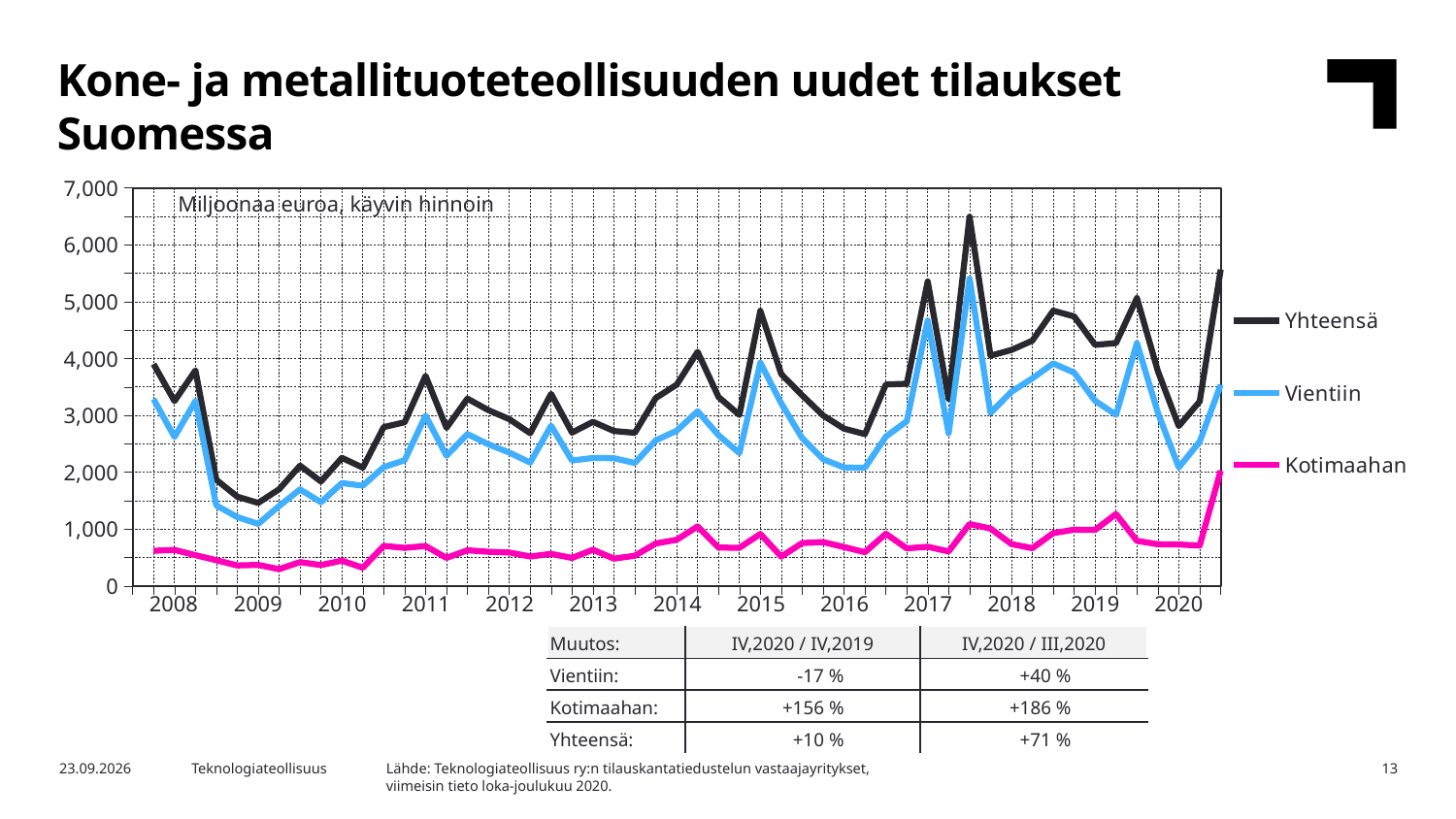
Is the value of Kotimaahan at the start of 2008 greater or less than 1,000? less What is the title of the chart on the slide? Kone- ja metallituoteteollisuuden uudet tilaukset Suomessa Which series has the highest values throughout the chart? Yhteensä How many year labels are shown on the x axis? 13 Is the peak value of Vientiin in 2017 greater or less than 5,000? greater What are the three series named in the legend? Yhteensä, Vientiin, Kotimaahan Is the peak value of Yhteensä in 2017 greater or less than 6,000? greater What kind of chart is shown on the slide? line chart Which series has the lowest values throughout the chart? Kotimaahan Which series is larger in 2015, Vientiin or Kotimaahan? Vientiin How many series does the legend list? 3